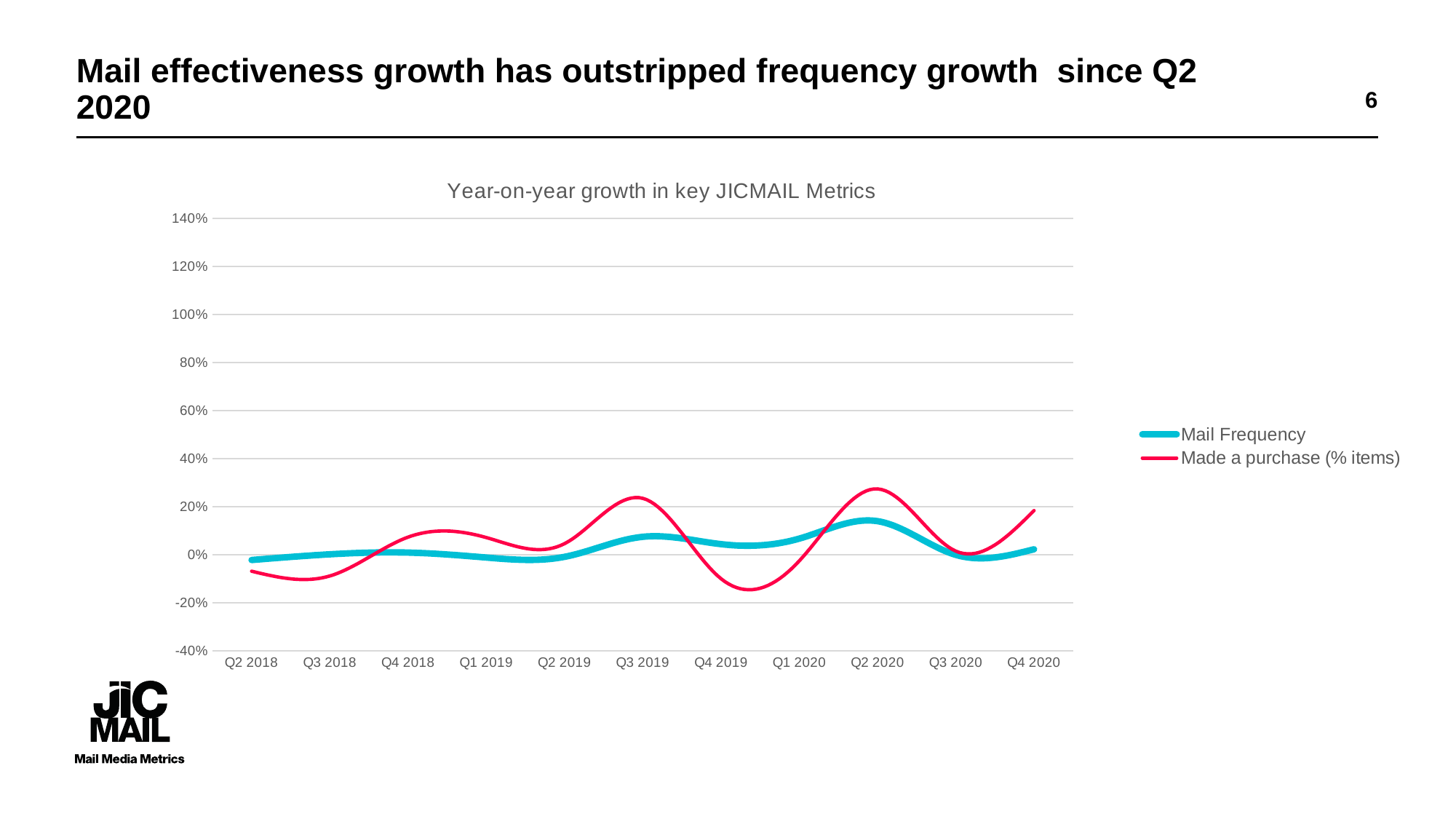
Which series is drawn in the thick blue line? Mail Frequency Is the value for Made a purchase (% items) in Q2 2020 greater or less than 20%? greater Does the Made a purchase (% items) series rise or fall from Q3 2020 to Q4 2020? rise In Q4 2019, which series has the higher value, Mail Frequency or Made a purchase (% items)? Mail Frequency How many series does the legend list? 2 What is the title of the chart? Year-on-year growth in key JICMAIL Metrics How many quarters are plotted along the x axis? 11 In which quarter does the Made a purchase (% items) series reach its highest value? Q2 2020 Is the value for Made a purchase (% items) in Q4 2019 greater or less than 0%? less In which quarter does the Mail Frequency series reach its highest value? Q2 2020 What kind of chart is shown on the slide? line chart In which quarter does the Made a purchase (% items) series reach its lowest value? Q4 2019